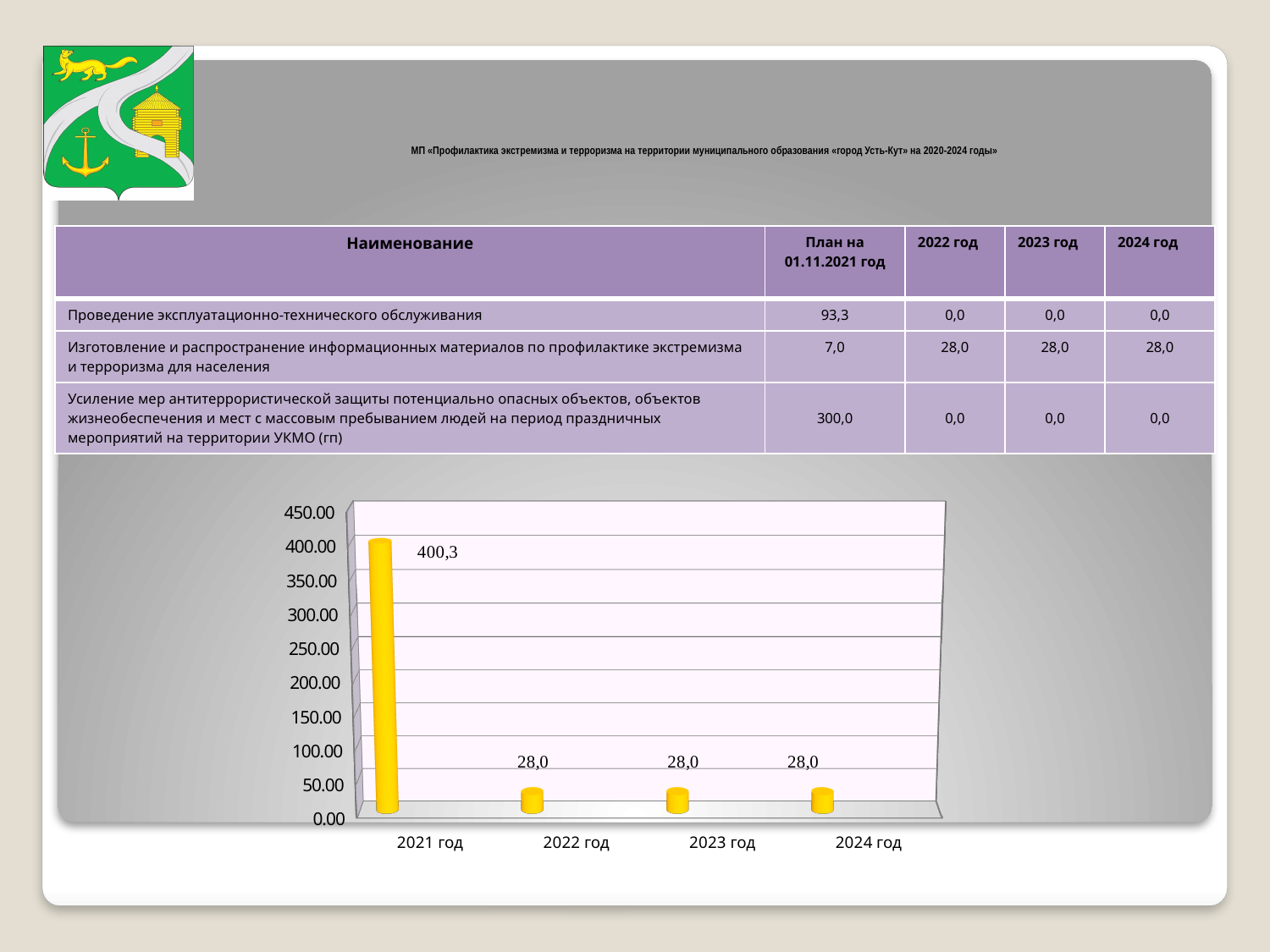
Which year has the highest value in the bar chart? 2021 год Which is larger in the bar chart, the value for 2021 год or the value for 2023 год? 2021 год What is the difference between the values for 2021 год and 2022 год in the bar chart? 372,3 What is the highest tick value shown on the y axis of the bar chart? 450.00 What kind of chart is shown on the slide? bar chart How many categories are shown on the x axis of the bar chart? 4 What is the value for 2022 год in the bar chart? 28,0 What is the value for 2024 год in the bar chart? 28,0 Is the value for 2023 год in the bar chart greater or less than 50.00? less Is the value for 2021 год in the bar chart greater or less than 350.00? greater Do the values in the bar chart rise or fall from 2021 год to 2022 год? fall What is the value for 2021 год in the bar chart? 400,3